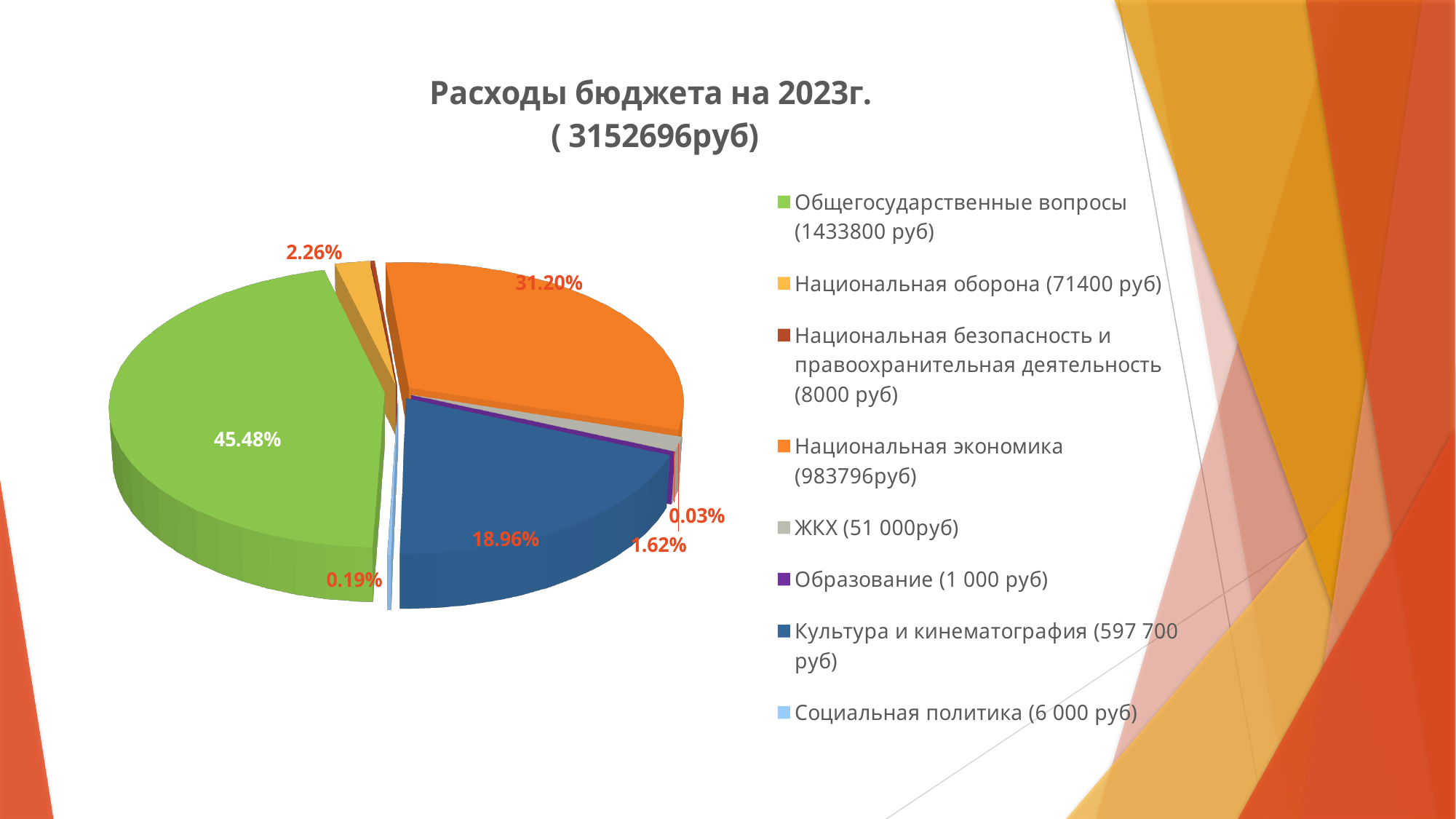
What share of the budget goes to Общегосударственные вопросы? 45.48% What kind of chart is shown on the slide? pie chart What amount in rubles does the legend give for Национальная экономика? 983796руб What percentage is shown for Национальная экономика? 31.20% How many categories are listed in the legend? 8 What percentage is shown for Культура и кинематография? 18.96% What share does Национальная оборона have in the pie chart? 2.26% What is the title of the chart? Расходы бюджета на 2023г. ( 3152696руб) Which category has the largest slice of the pie? Общегосударственные вопросы What percentage is shown for ЖКХ? 1.62% Which is larger: the slice for Национальная экономика or the slice for Культура и кинематография? Национальная экономика What is the difference in percentage points between the Общегосударственные вопросы slice and the Национальная экономика slice? 14.28%